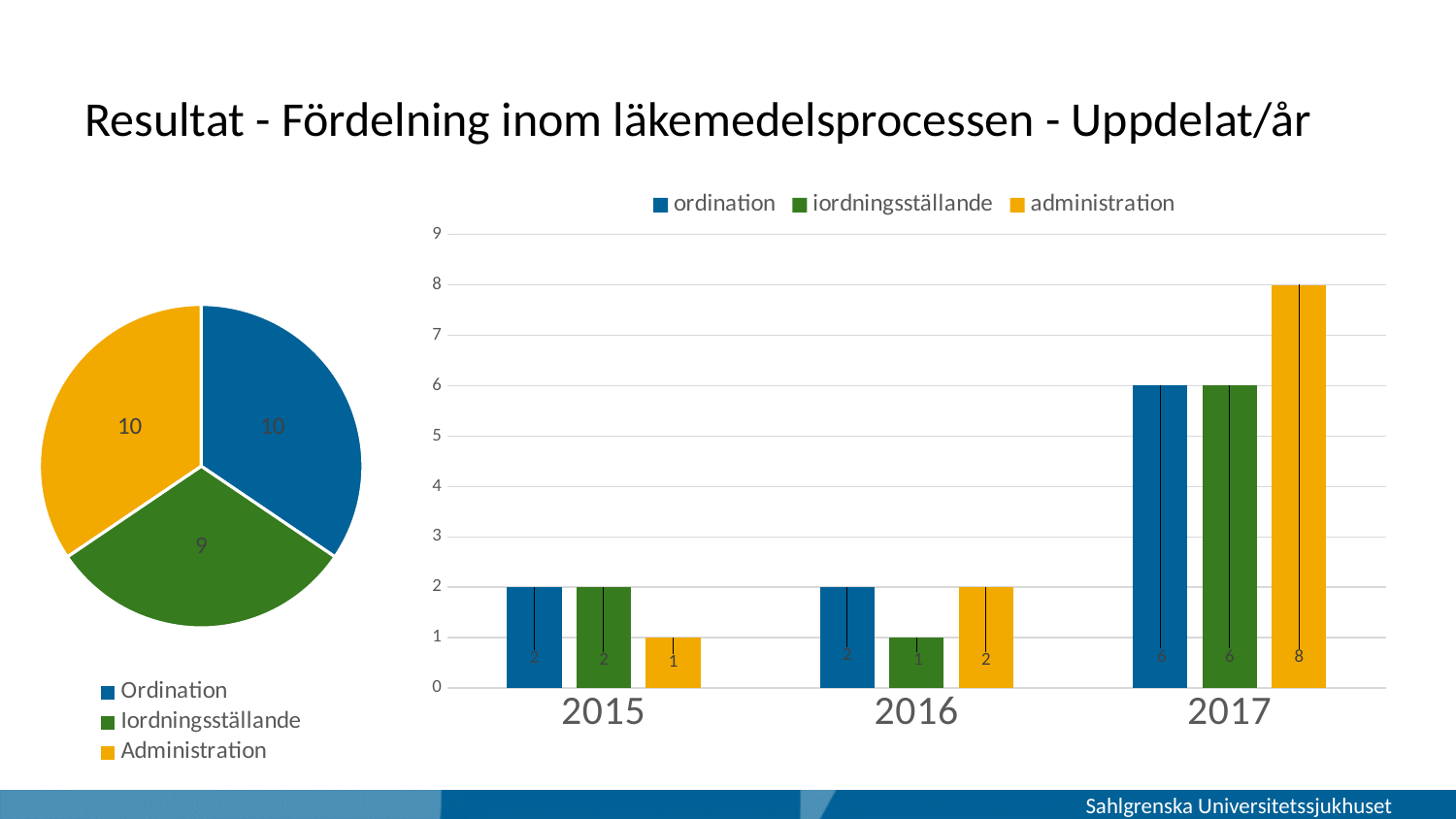
In the bar chart on the right, what is the value for iordningsställande in 2016? 1 In the bar chart on the right, is the value for ordination in 2017 larger or smaller than the value for administration in 2017? smaller In the pie chart on the left, which category has the smallest slice? Iordningsställande In the bar chart on the right, which year has the highest value for administration? 2017 In the bar chart on the right, what is the value for administration in 2017? 8 What kind of chart is shown on the right side of the slide? bar chart In the bar chart on the right, what is the difference between the administration value in 2017 and the administration value in 2015? 7 In the pie chart on the left, what is the value for Iordningsställande? 9 In the bar chart on the right, which series has the lowest value in 2015? administration In the bar chart on the right, what is the value for ordination in 2015? 2 In the bar chart on the right, how many series does the legend list? 3 In the bar chart on the right, how many years are shown on the x axis? 3